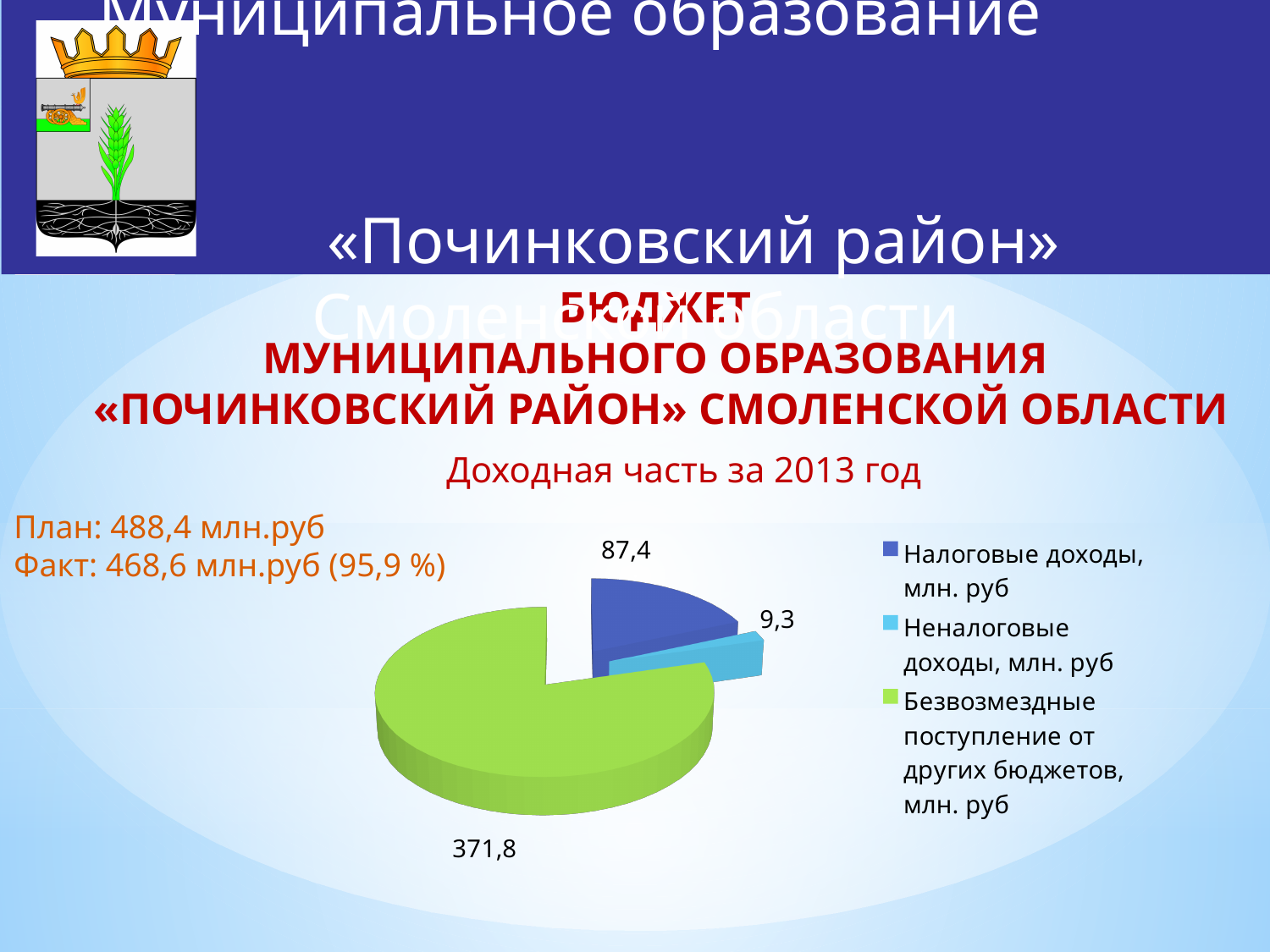
Which category has the largest slice in the pie chart? Безвозмездные поступление от других бюджетов Which is larger in the pie chart: Налоговые доходы or Неналоговые доходы? Налоговые доходы What is the value for Безвозмездные поступление от других бюджетов in the pie chart? 371,8 What type of chart is shown on the slide? Pie chart What is the value for Налоговые доходы in the pie chart? 87,4 What is the difference between the values for Безвозмездные поступление от других бюджетов and Налоговые доходы? 284,4 What colour is the slice for Безвозмездные поступление от других бюджетов in the pie chart? Green What is the difference between the values for Налоговые доходы and Неналоговые доходы? 78,1 Which category has the smallest slice in the pie chart? Неналоговые доходы How many slices does the pie chart have? 3 What is the value for Неналоговые доходы in the pie chart? 9,3 How many entries does the legend of the pie chart list? 3